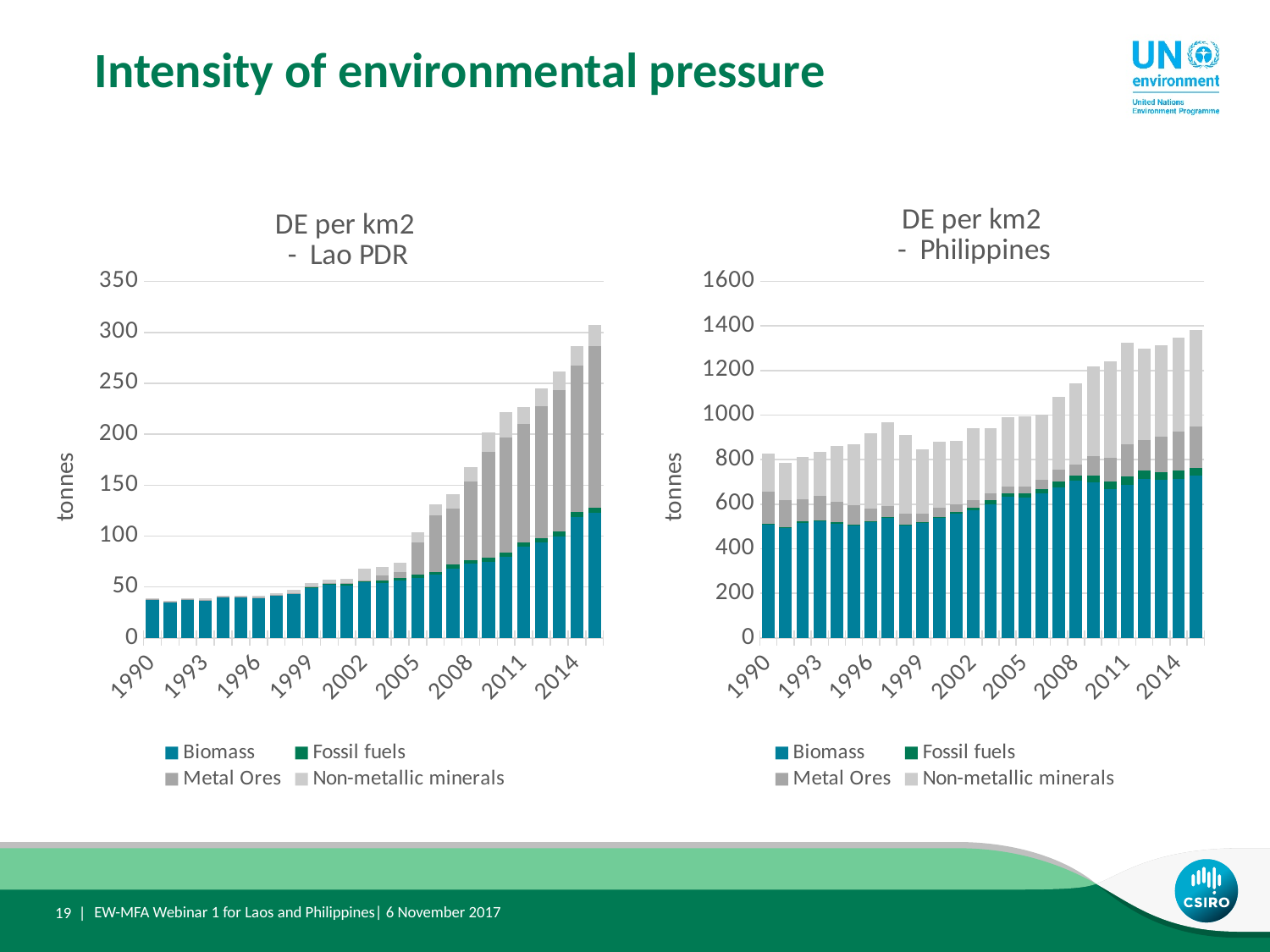
How many series does the legend of the 'DE per km2 - Philippines' chart list? 4 In the 'DE per km2 - Philippines' chart, is the total for 1990 greater or less than 1000? less What is the y-axis label on the 'DE per km2 - Lao PDR' chart? tonnes In the 'DE per km2 - Philippines' chart, which year has the larger total, 1990 or 2014? 2014 In the 'DE per km2 - Lao PDR' chart, is the total for 1990 greater or less than 50? less In the 'DE per km2 - Lao PDR' chart, is the total for 2014 greater or less than 250? greater What kind of chart is the 'DE per km2 - Lao PDR' chart? Stacked bar chart Which series is shown at the bottom of each stacked bar in the 'DE per km2 - Philippines' chart? Biomass In the 'DE per km2 - Lao PDR' chart, do the total bar heights rise or fall from 1990 to the last year shown? Rise